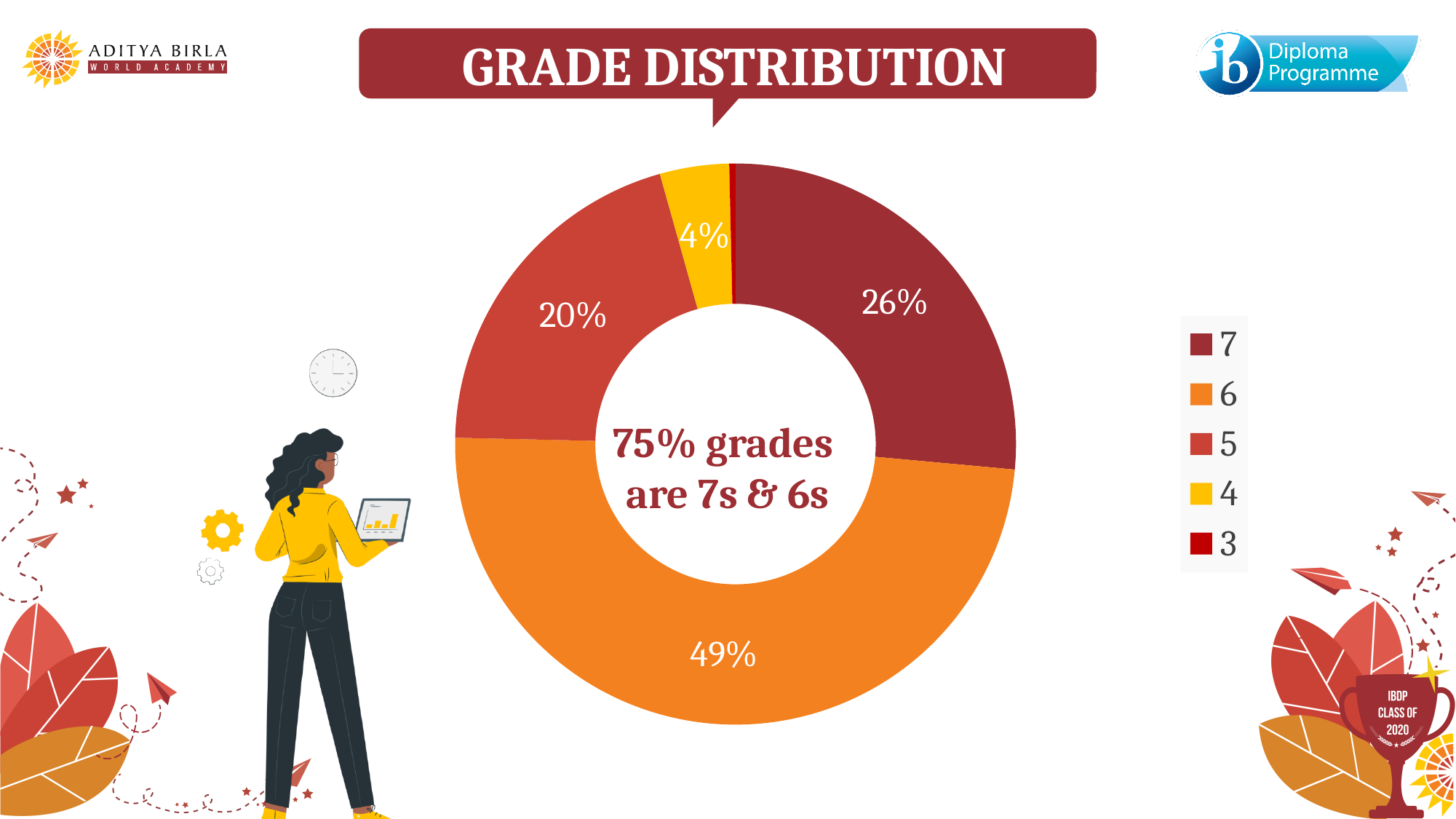
What share of grades does the grade 5 slice represent? 20% Which has a larger share, grade 7 or grade 5? Grade 7 What type of chart is shown on the slide? Pie (donut) chart What percentage of grades are 7s? 26% What is the title of the chart? GRADE DISTRIBUTION What percentage of grades are 6s according to the chart? 49% What percentage is shown for grade 4? 4% How many grade categories does the legend list? 5 Which grade has the largest share of the chart? 6 Which grade has the smallest slice in the chart? 3 How many percentage points larger is the share of grade 6 than the share of grade 7? 23 What is the difference in percentage points between the grade 7 share and the grade 5 share? 6